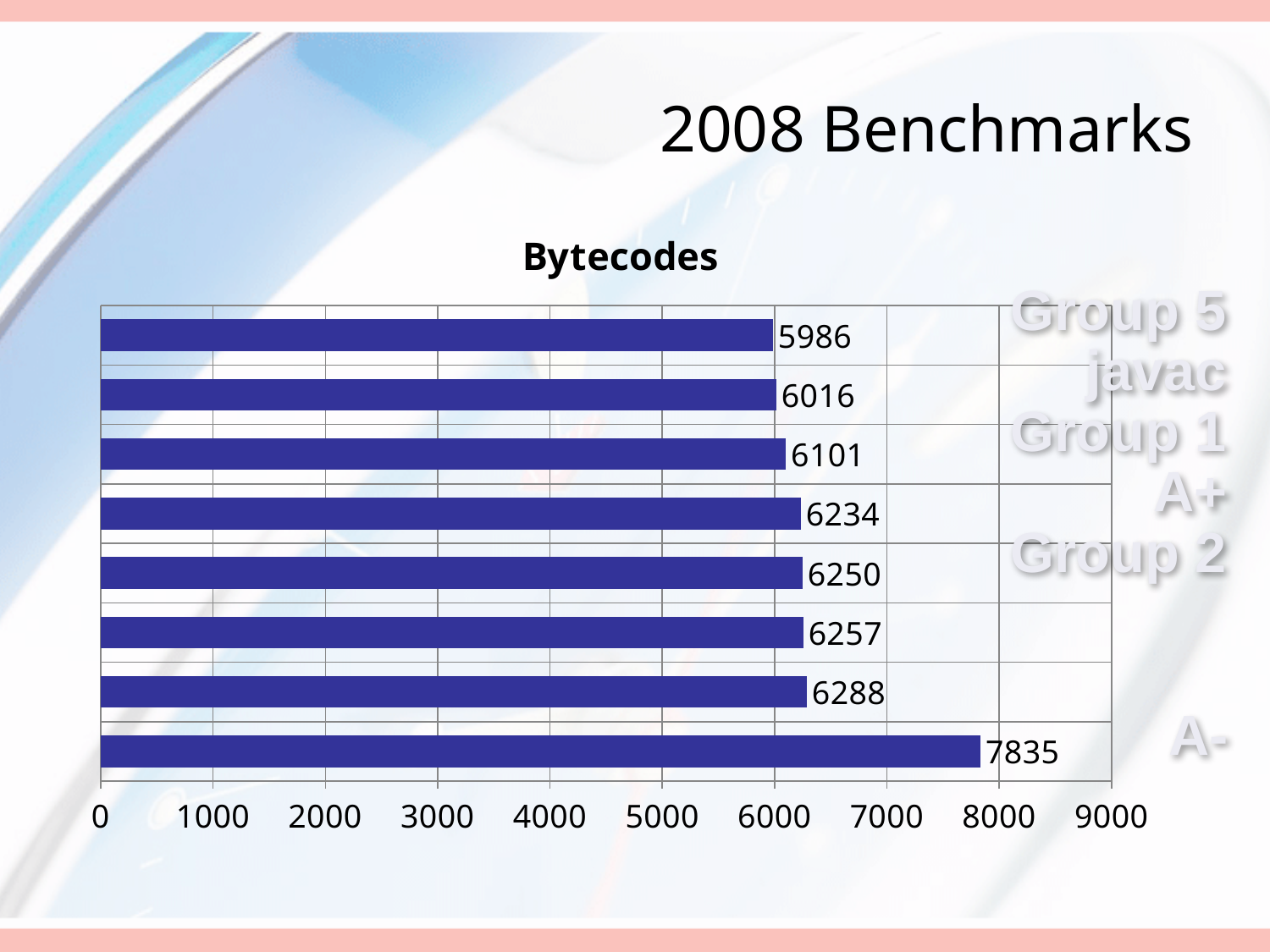
What is the title of the chart? Bytecodes How many bars are plotted in the chart? 8 What is the lowest value shown in the chart? 5986 What is the difference between the largest value (7835) and the smallest value (5986)? 1849 What is the value of the fourth bar from the top? 6234 Do the bar values increase or decrease going from the top bar to the bottom bar? increase What is the difference between the second bar from the bottom (6288) and the top bar (5986)? 302 Is the value of the bottom bar greater or less than 7000? greater What is the value of the top bar in the chart? 5986 What is the value of the bottom bar in the chart? 7835 What kind of chart is shown on the slide? bar chart What is the highest value shown in the chart? 7835